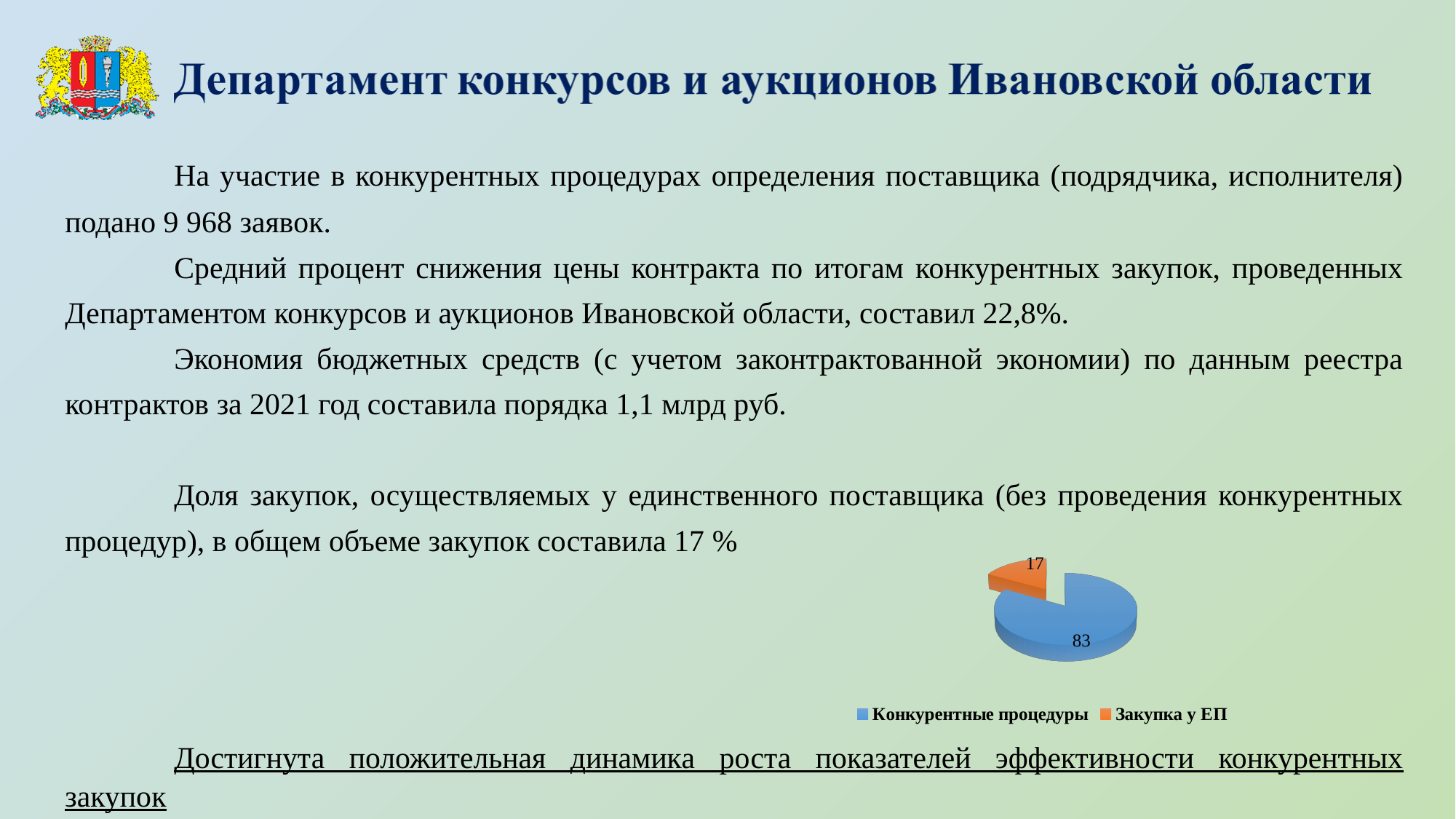
What is the value shown for Закупка у ЕП in the pie chart? 17 Which category has the smallest slice in the pie chart? Закупка у ЕП What share of the pie does Закупка у ЕП represent? 17% What is the difference between the values for Конкурентные процедуры and Закупка у ЕП in the pie chart? 66 How many entries does the legend of the pie chart list? 2 Which category has the largest slice in the pie chart? Конкурентные процедуры What colour is the Закупка у ЕП slice in the pie chart? orange What kind of chart is shown on the slide? pie chart What is the total of the two values shown in the pie chart? 100 How many slices does the pie chart have? 2 Which is larger in the pie chart: Конкурентные процедуры or Закупка у ЕП? Конкурентные процедуры What is the value shown for Конкурентные процедуры in the pie chart? 83